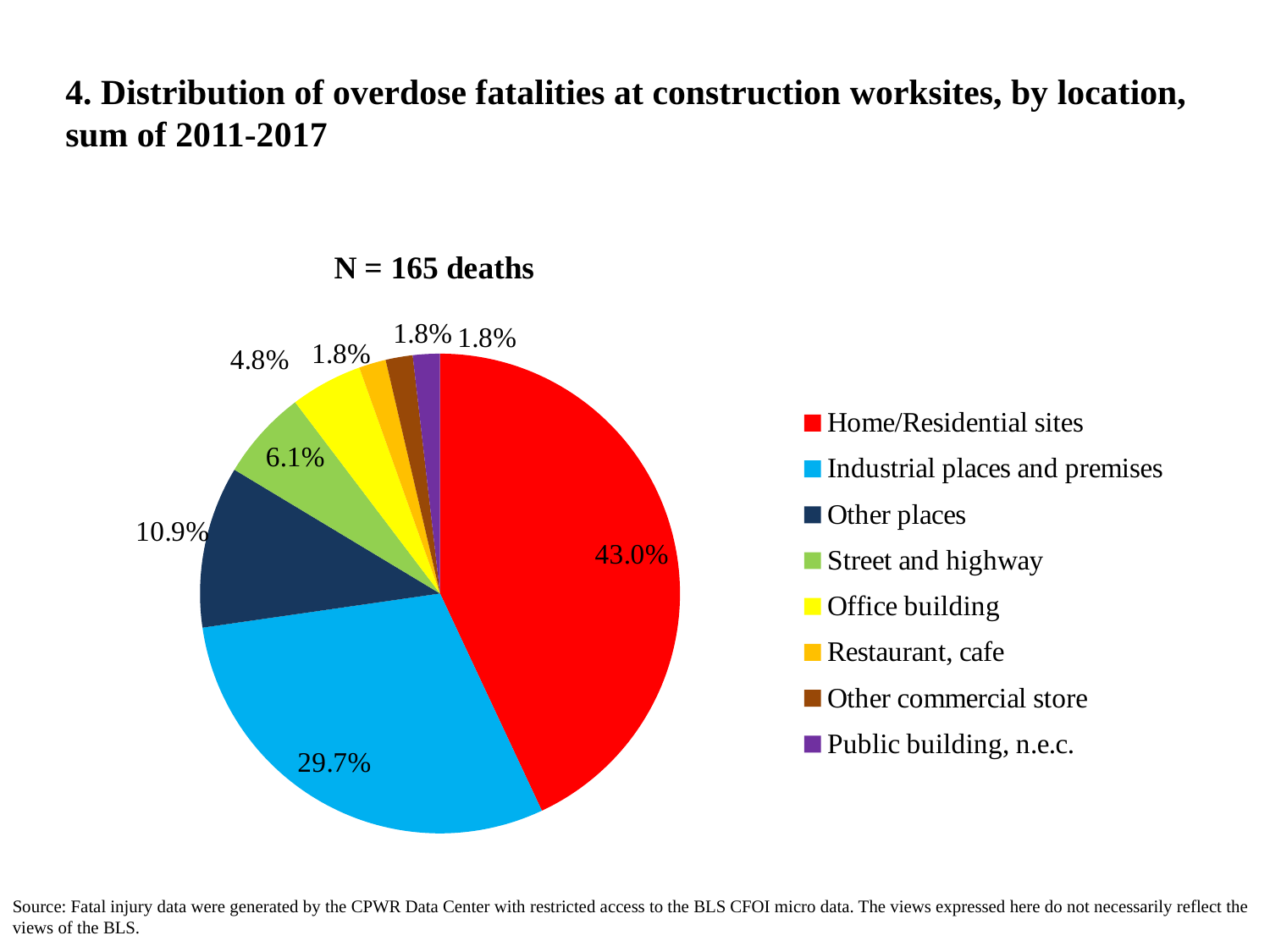
What kind of chart is shown on the slide? pie chart What percentage is shown for Other places? 10.9% What is the total number of deaths (N) stated above the pie chart? 165 What share of overdose fatalities occurred at Home/Residential sites? 43.0% Which location has the largest share of overdose fatalities? Home/Residential sites What percentage is shown for Street and highway? 6.1% Which is larger, the share for Other places or the share for Street and highway? Other places What percentage is shown for Restaurant, cafe? 1.8% What share of overdose fatalities occurred at Industrial places and premises? 29.7% What percentage is shown for Office building? 4.8% How many location categories does the legend list? 8 What is the difference in percentage points between Home/Residential sites and Industrial places and premises? 13.3